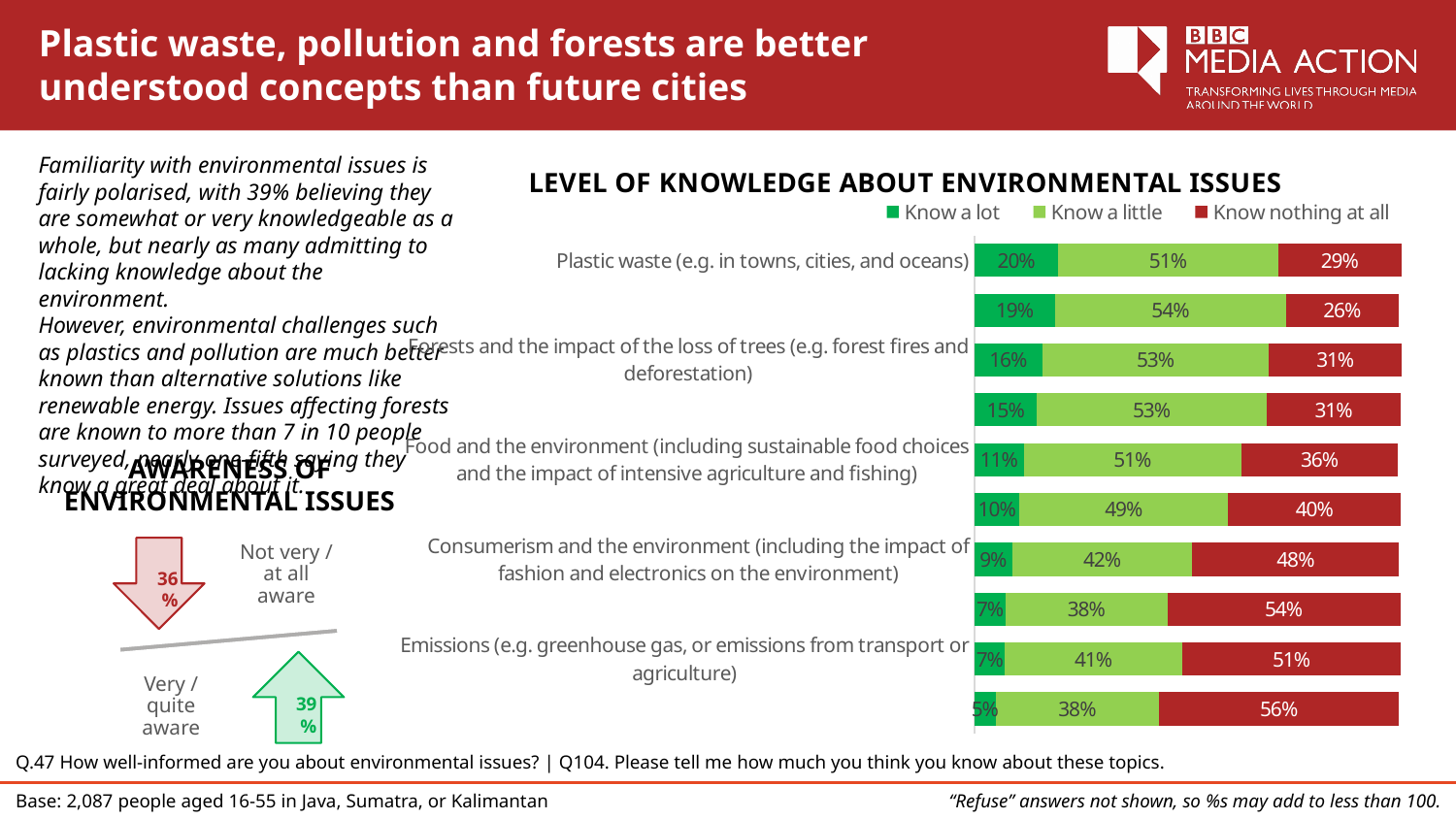
In the chart 'Level of knowledge about environmental issues', what colour represents 'Know nothing at all'? Red In the chart 'Level of knowledge about environmental issues', what is the difference in 'Know nothing at all' between consumerism and the environment and plastic waste? 19 percentage points How many series does the legend of the 'Level of knowledge about environmental issues' chart list? 3 In the chart 'Level of knowledge about environmental issues', which has the larger 'Know a little' share: food and the environment or consumerism and the environment? Food and the environment In the chart 'Level of knowledge about environmental issues', which topic has the highest 'Know a lot' percentage? Plastic waste What kind of chart is 'Level of knowledge about environmental issues'? Stacked bar chart In the chart 'Level of knowledge about environmental issues', what is the total of the three segments for the plastic waste bar? 100% In the chart 'Level of knowledge about environmental issues', what percentage say they 'Know nothing at all' about consumerism and the environment? 48% How many bars are shown in the 'Level of knowledge about environmental issues' chart? 10 In the chart 'Level of knowledge about environmental issues', what percentage say they 'Know a little' about forests and the impact of the loss of trees? 53% In the chart 'Level of knowledge about environmental issues', what percentage say they 'Know nothing at all' about emissions? 51% In the chart 'Level of knowledge about environmental issues', what percentage say they 'Know a lot' about plastic waste? 20%